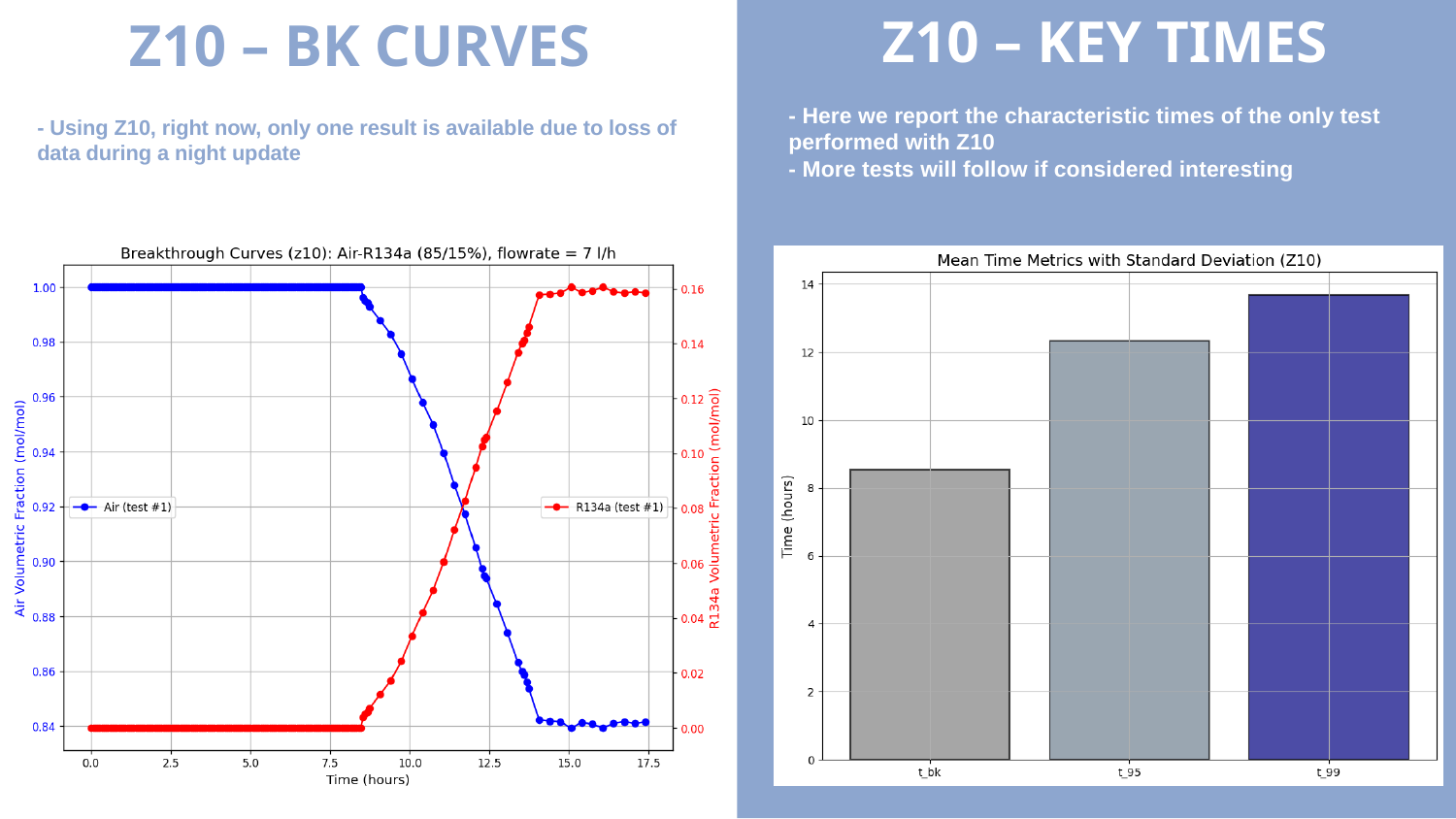
In the 'Mean Time Metrics with Standard Deviation (Z10)' chart, which category has the lowest value? t_bk In the 'Mean Time Metrics with Standard Deviation (Z10)' chart, is the value for t_bk greater or less than 10? less How many bars are shown in the 'Mean Time Metrics with Standard Deviation (Z10)' chart? 3 In the 'Mean Time Metrics with Standard Deviation (Z10)' chart, which is larger, t_95 or t_99? t_99 In the 'Mean Time Metrics with Standard Deviation (Z10)' chart, do the bar values rise or fall from t_bk to t_99? rise In the 'Breakthrough Curves (z10)' chart, does the R134a volumetric fraction rise or fall over time? rise What kind of chart is the 'Breakthrough Curves (z10)' chart on the left? line chart In the 'Mean Time Metrics with Standard Deviation (Z10)' chart, which category has the highest value? t_99 What kind of chart is the 'Mean Time Metrics with Standard Deviation (Z10)' chart? bar chart In the 'Breakthrough Curves (z10)' chart, what colour is the Air (test #1) series? blue In the 'Mean Time Metrics with Standard Deviation (Z10)' chart, is the value for t_95 greater or less than 12? greater How many series are plotted in the 'Breakthrough Curves (z10)' chart on the left? 2